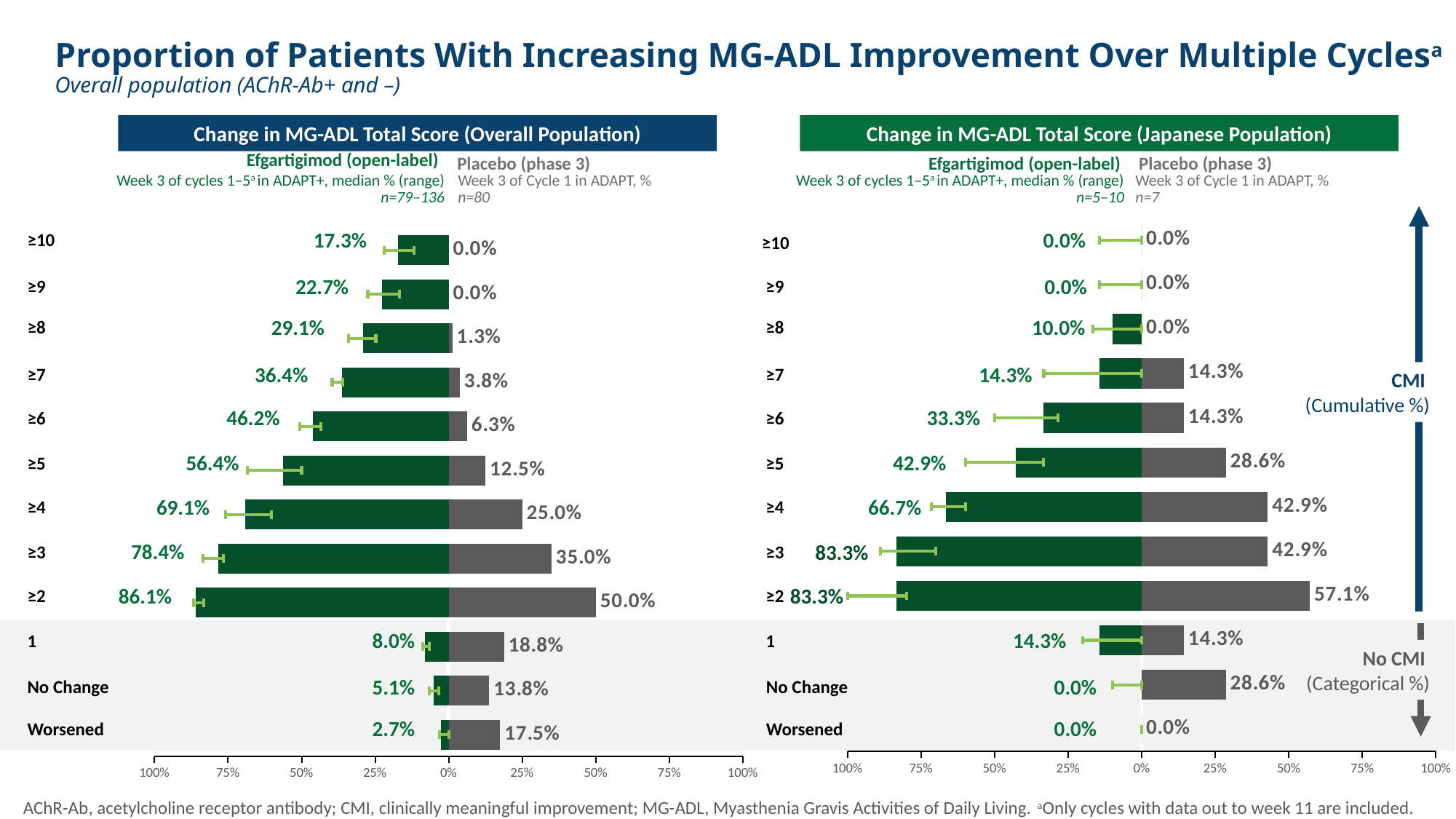
What type of chart is the Japanese Population chart? Bar chart In the Overall Population chart, do the efgartigimod values rise or fall going from ≥10 down to ≥2? Rise In the Japanese Population chart, what is the efgartigimod value for the ≥6 category? 33.3% How many categories are listed on the y axis of the Overall Population chart? 12 In the Overall Population chart, which category has the highest placebo value? ≥2 In the Overall Population chart, which is larger for the No Change category: the efgartigimod value or the placebo value? Placebo In the Japanese Population chart, what is the difference between the efgartigimod and placebo values for the ≥4 category? 23.8% In the Overall Population chart, which category has the lowest efgartigimod value? Worsened In the Overall Population chart, what is the efgartigimod value for the ≥2 category? 86.1% In the Overall Population chart, what is the placebo value for the ≥4 category? 25.0% In the Overall Population chart, what is the difference between the efgartigimod and placebo values for the ≥3 category? 43.4% In the Japanese Population chart, what is the placebo value for the ≥2 category? 57.1%